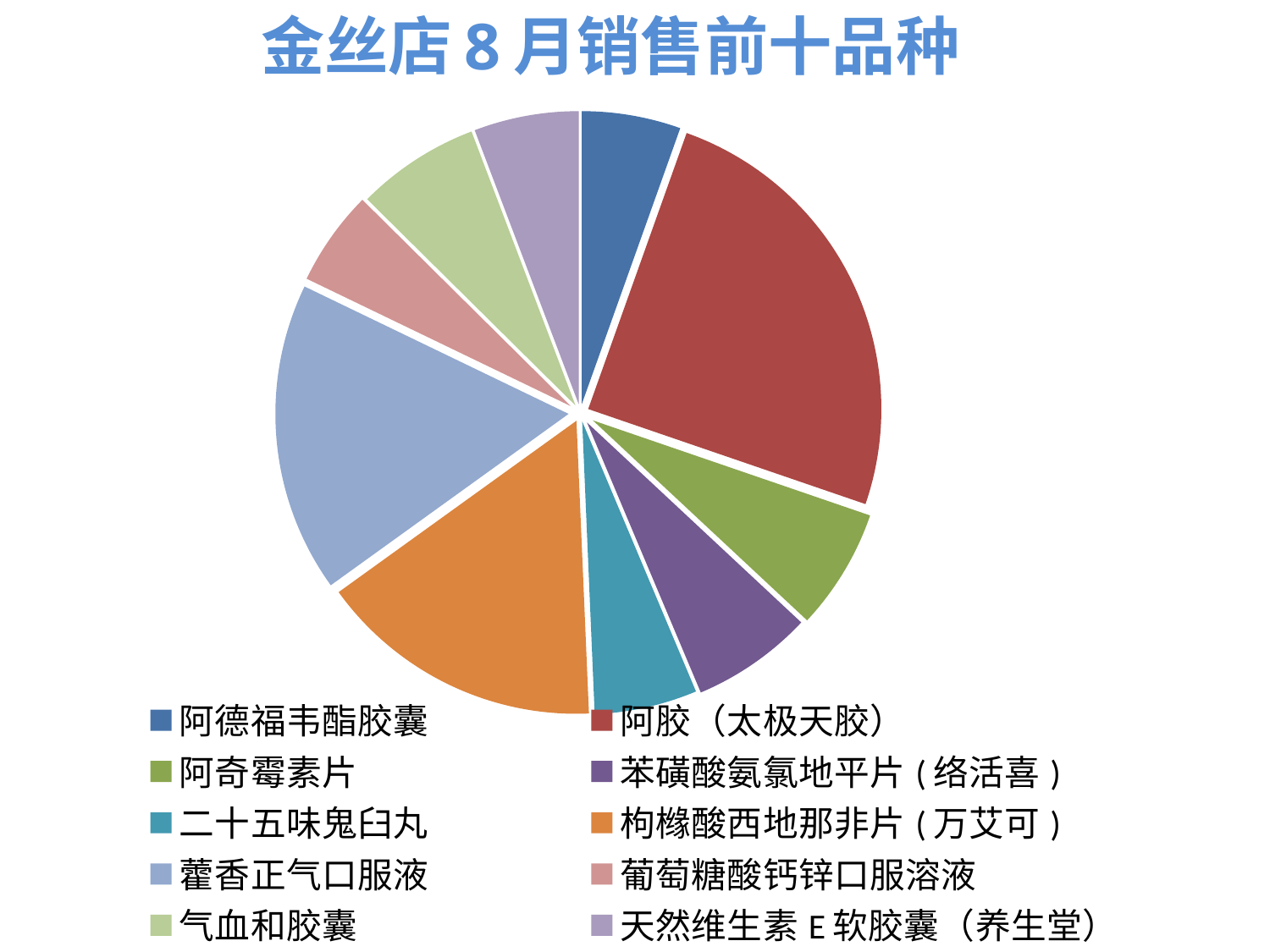
Which slice is larger, 藿香正气口服液 or 葡萄糖酸钙锌口服溶液? 藿香正气口服液 Which slice is larger, 阿胶（太极天胶） or 藿香正气口服液? 阿胶（太极天胶） Which slice is larger, 枸橼酸西地那非片（万艾可） or 二十五味鬼臼丸? 枸橼酸西地那非片（万艾可） What colour is the slice for 阿胶（太极天胶）? Red What kind of chart is shown on the slide? Pie chart How many slices does the pie chart have? 10 Which product has the largest slice of the pie? 阿胶（太极天胶） What is the title of the chart? 金丝店8月销售前十品种